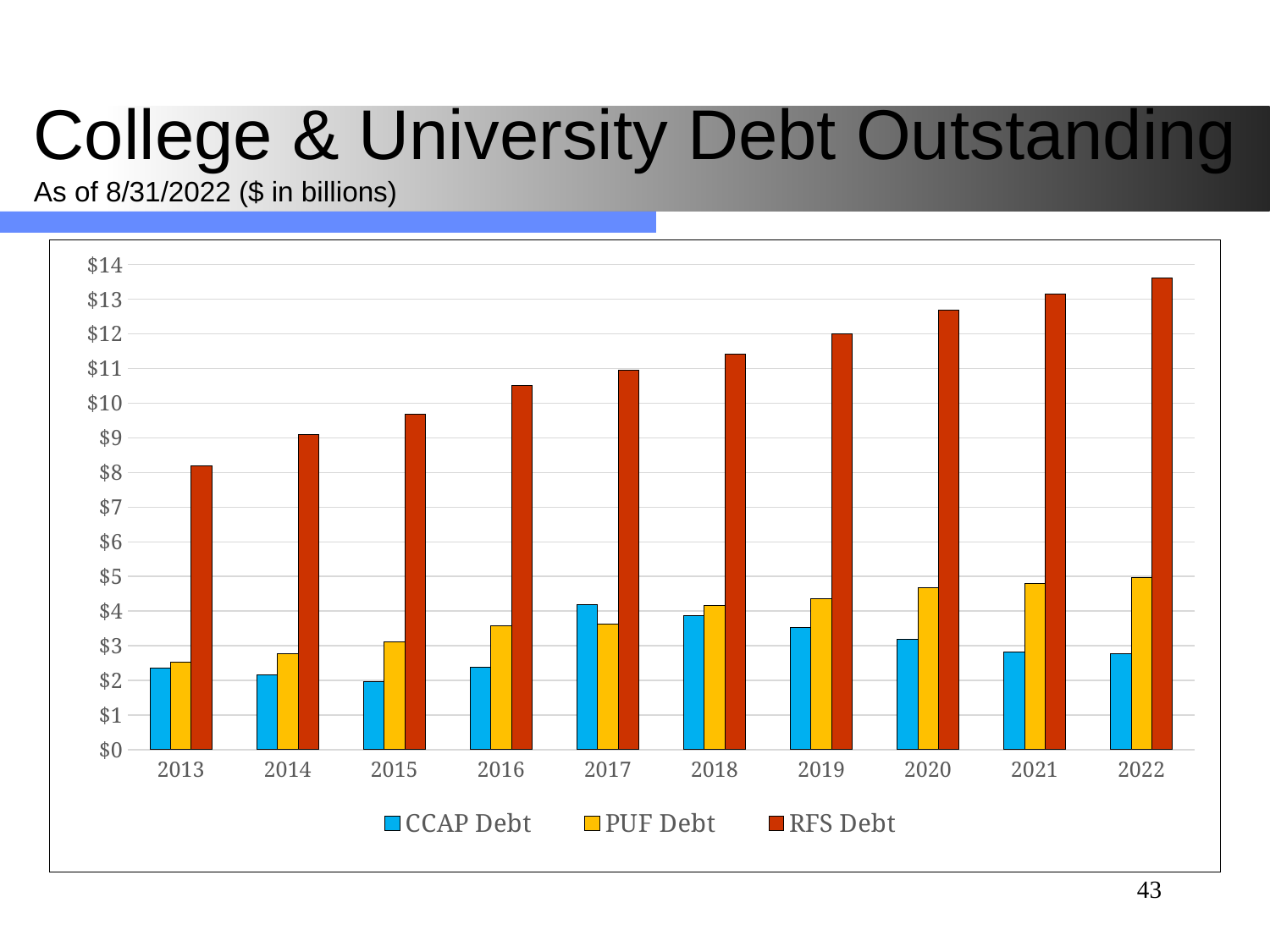
Which year has the highest RFS Debt? 2022 How many years are shown on the x axis? 10 Which year has the lowest RFS Debt? 2013 What kind of chart is shown on the slide? Bar chart Does RFS Debt rise or fall from 2013 to 2022? Rise In 2017, which is larger, CCAP Debt or PUF Debt? CCAP Debt Is the value for RFS Debt in 2016 greater or less than $10? greater What is the title of the slide containing the chart? College & University Debt Outstanding Which year has the highest CCAP Debt? 2017 Is the value for RFS Debt in 2022 greater or less than $13? greater Is the value for PUF Debt in 2019 greater or less than $4? greater How many series does the legend list? 3